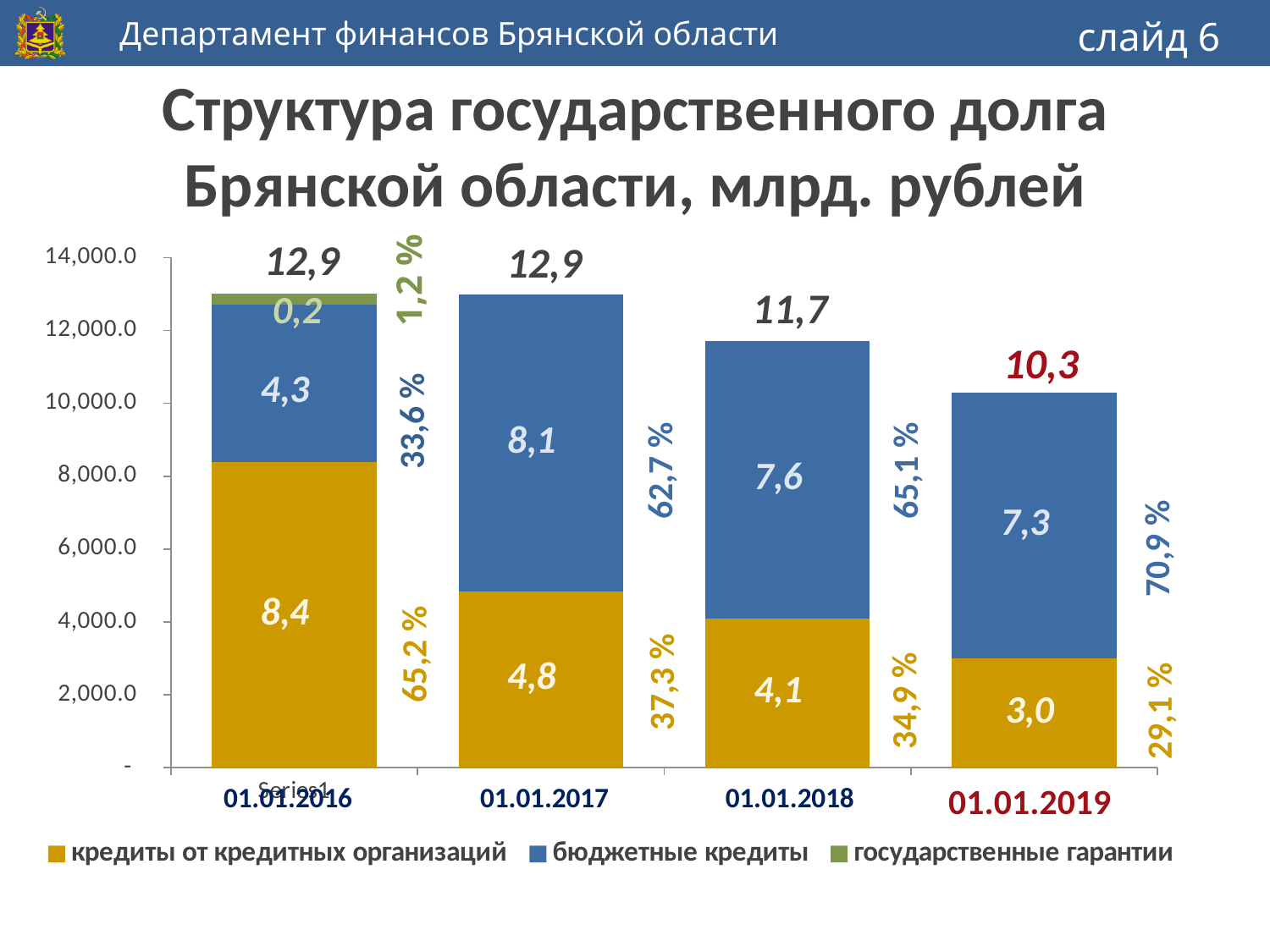
What share of the total debt on 01.01.2019 is 'бюджетные кредиты', according to the percentage label? 70,9 % Which date has the lowest total state debt? 01.01.2019 Which is larger on 01.01.2017: 'кредиты от кредитных организаций' or 'бюджетные кредиты'? бюджетные кредиты How many dates (categories) are shown on the x axis? 4 What is the difference between 'бюджетные кредиты' on 01.01.2017 (8,1) and on 01.01.2019 (7,3)? 0,8 What is the value of 'кредиты от кредитных организаций' on 01.01.2016? 8,4 What type of chart is shown on the slide? stacked bar chart Does the total state debt rise or fall from 01.01.2017 to 01.01.2019? fall What is the value of 'бюджетные кредиты' on 01.01.2018? 7,6 What is the value of 'государственные гарантии' on 01.01.2016? 0,2 How many series does the legend list? 3 What is the total state debt shown above the bar for 01.01.2019? 10,3